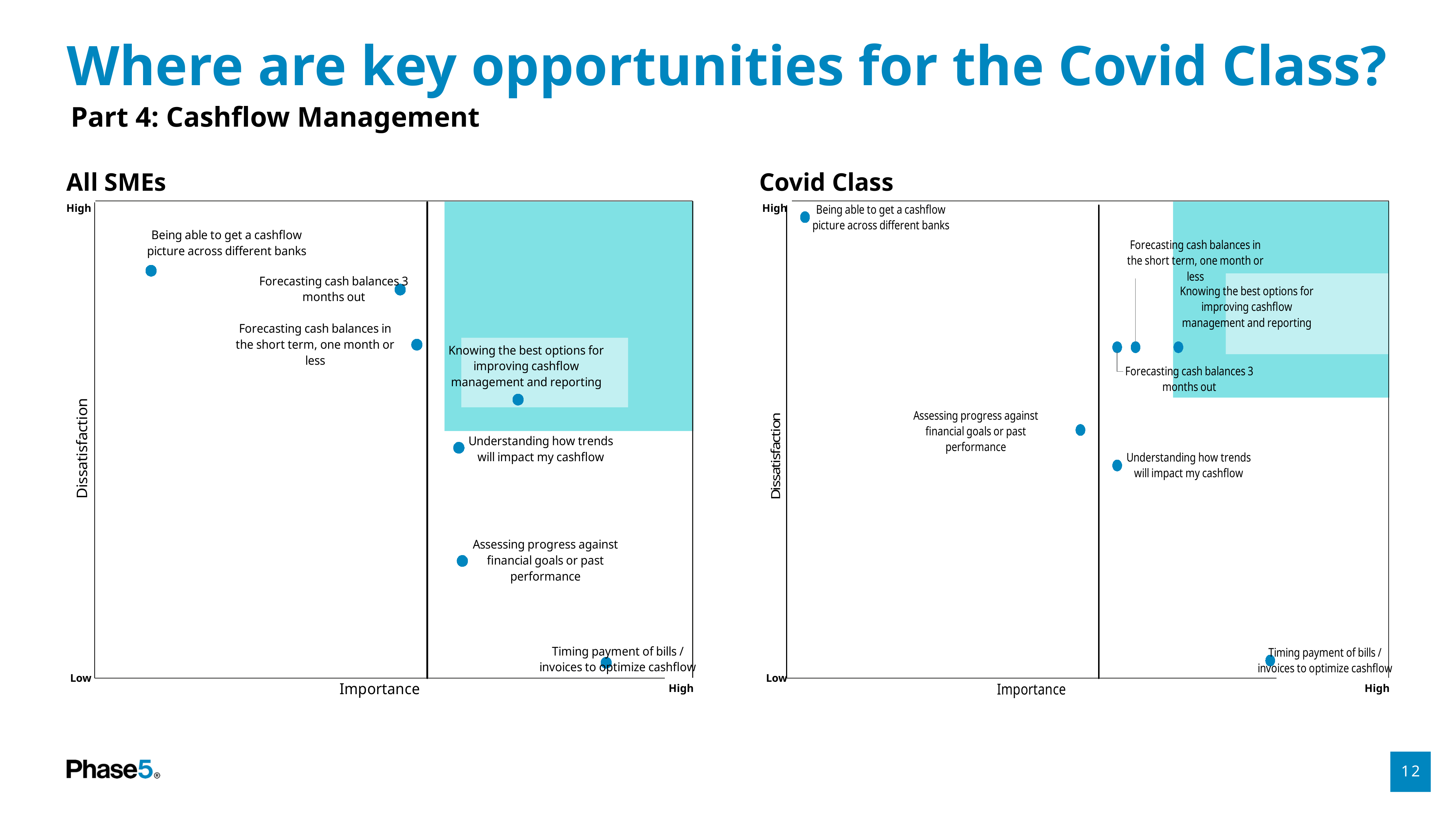
On the Covid Class chart, which item has the highest dissatisfaction? Being able to get a cashflow picture across different banks On the All SMEs chart, which item has the lowest dissatisfaction? Timing payment of bills / invoices to optimize cashflow On the All SMEs chart, which has higher importance: Knowing the best options for improving cashflow management and reporting, or Forecasting cash balances 3 months out? Knowing the best options for improving cashflow management and reporting On the Covid Class chart, which item has the lowest importance? Being able to get a cashflow picture across different banks How many data points are plotted on the Covid Class chart? 7 What is the label of the horizontal axis on the Covid Class chart? Importance On the Covid Class chart, which item has the highest importance? Timing payment of bills / invoices to optimize cashflow How many data points are plotted on the All SMEs chart? 7 On the Covid Class chart, which has higher dissatisfaction: Assessing progress against financial goals or past performance, or Understanding how trends will impact my cashflow? Assessing progress against financial goals or past performance What kind of chart is the All SMEs chart? Scatter chart On the All SMEs chart, which item has the highest dissatisfaction? Being able to get a cashflow picture across different banks What is the label of the vertical axis on the All SMEs chart? Dissatisfaction